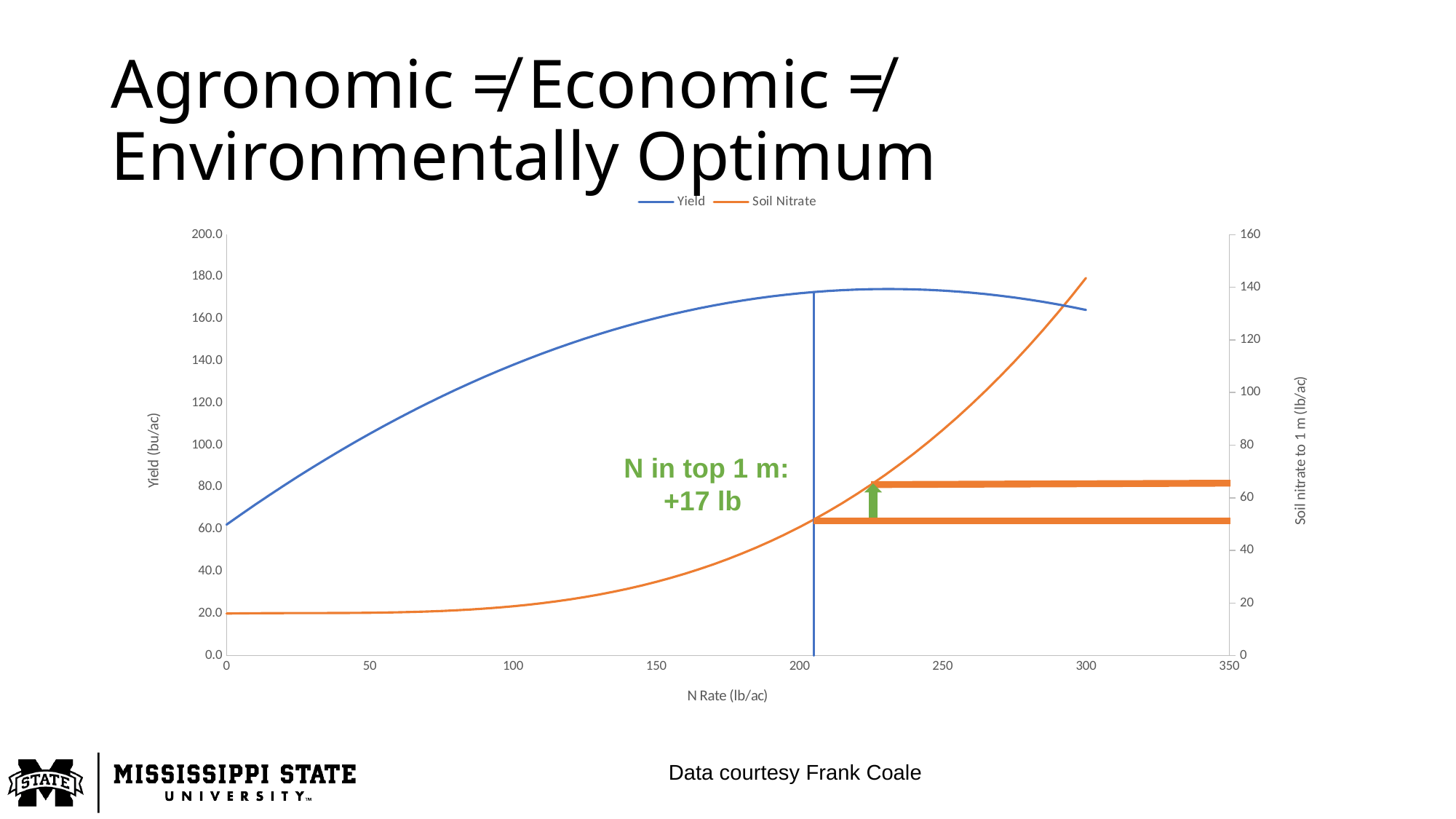
What kind of chart is shown on the slide? line chart Does the Yield line rise or fall as N Rate increases from 0 to 200? rise Does the Soil Nitrate line rise or fall as N Rate increases from 0 to 300? rise What is the title of the x axis of the chart? N Rate (lb/ac) Is the Yield value at an N Rate of 0 greater or less than 80? less Is the Soil Nitrate value at an N Rate of 100 greater or less than 40? less Is the Yield value at an N Rate of 100 greater or less than 120? greater How many series does the chart legend list? 2 What are the two series named in the chart legend? Yield and Soil Nitrate